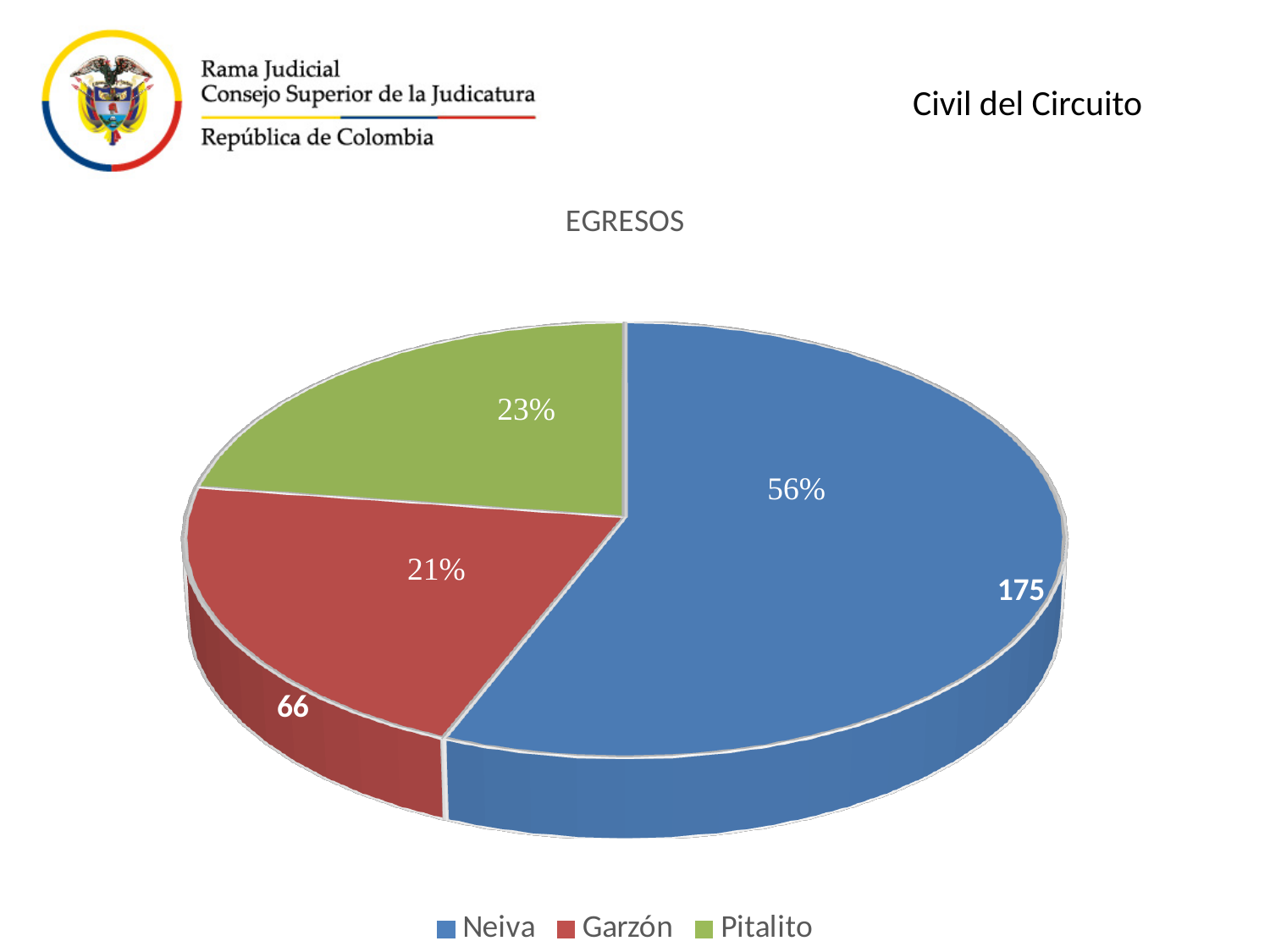
What is the value shown for Neiva? 175 Which category has the largest slice of the pie? Neiva Which category has the smallest slice of the pie? Garzón Which categories are listed in the legend? Neiva, Garzón, Pitalito What share of the pie does Garzón represent? 21% What kind of chart is shown on the slide? pie chart What share of the pie does Neiva represent? 56% What is the title of the chart? EGRESOS What share of the pie does Pitalito represent? 23% What is the value shown for Garzón? 66 What is the difference between the values for Neiva and Garzón? 109 How many slices does the pie chart have? 3